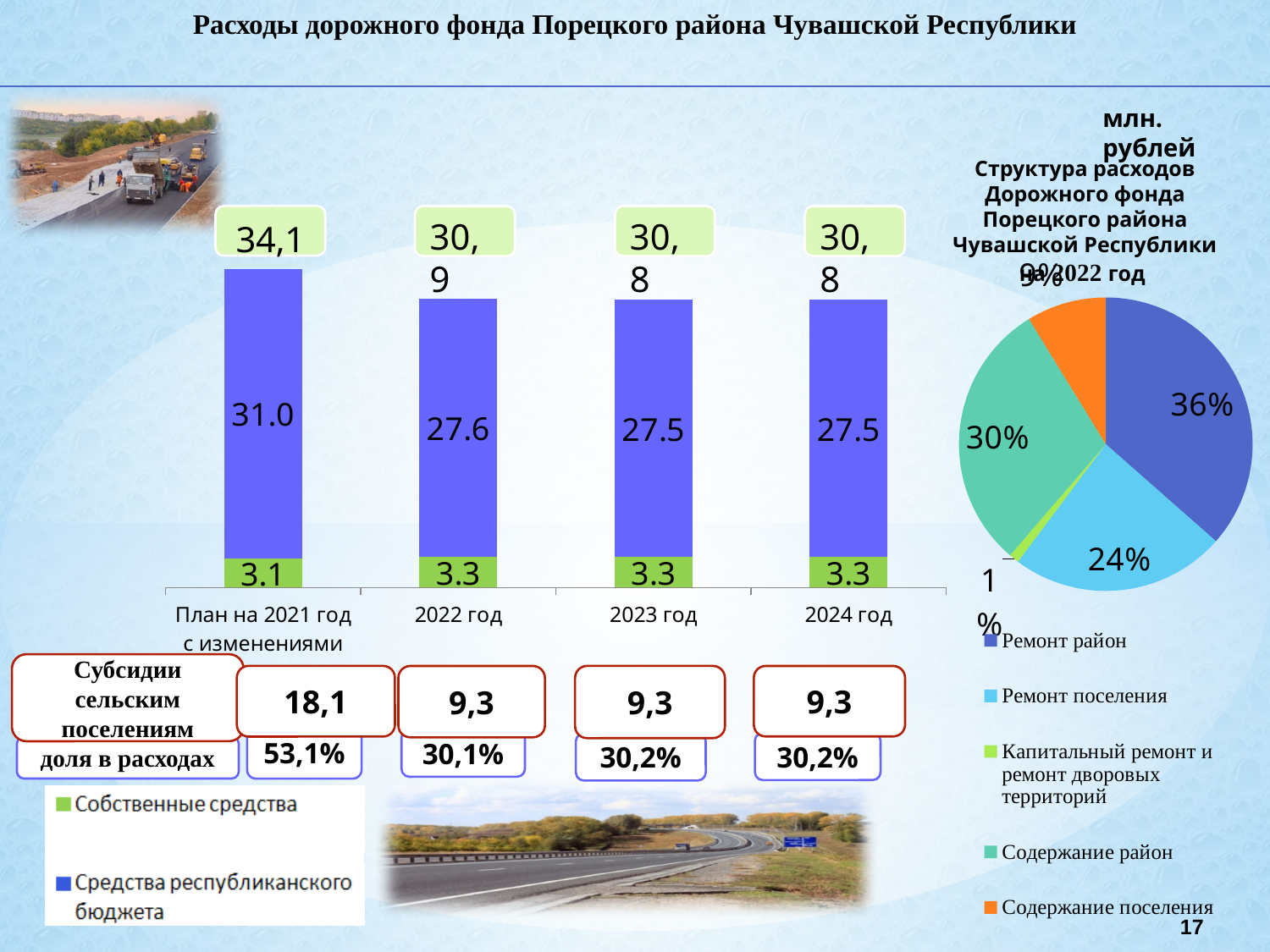
In the pie chart on the right, which category has the smallest slice? Капитальный ремонт и ремонт дворовых территорий In the stacked bar chart on the left, what is the total shown above the bar for План на 2021 год с изменениями? 34,1 What type of chart is the chart on the left of the slide? Stacked bar chart In the pie chart on the right, what share does Ремонт район have? 36% In the stacked bar chart on the left, which category has the highest value for Средства республиканского бюджета? План на 2021 год с изменениями In the stacked bar chart on the left, what is the difference between the Средства республиканского бюджета values for План на 2021 год с изменениями and 2022 год? 3.4 In the stacked bar chart on the left, what is the value of Средства республиканского бюджета for 2022 год? 27.6 In the stacked bar chart on the left, how many series does the legend list? 2 In the stacked bar chart on the left, how many categories are shown on the x axis? 4 In the pie chart on the right, what is the difference between the shares of Содержание район and Ремонт поселения? 6% In the stacked bar chart on the left, which is larger: Собственные средства for 2023 год or Собственные средства for План на 2021 год с изменениями? 2023 год In the stacked bar chart on the left, what is the value of Собственные средства for План на 2021 год с изменениями? 3.1